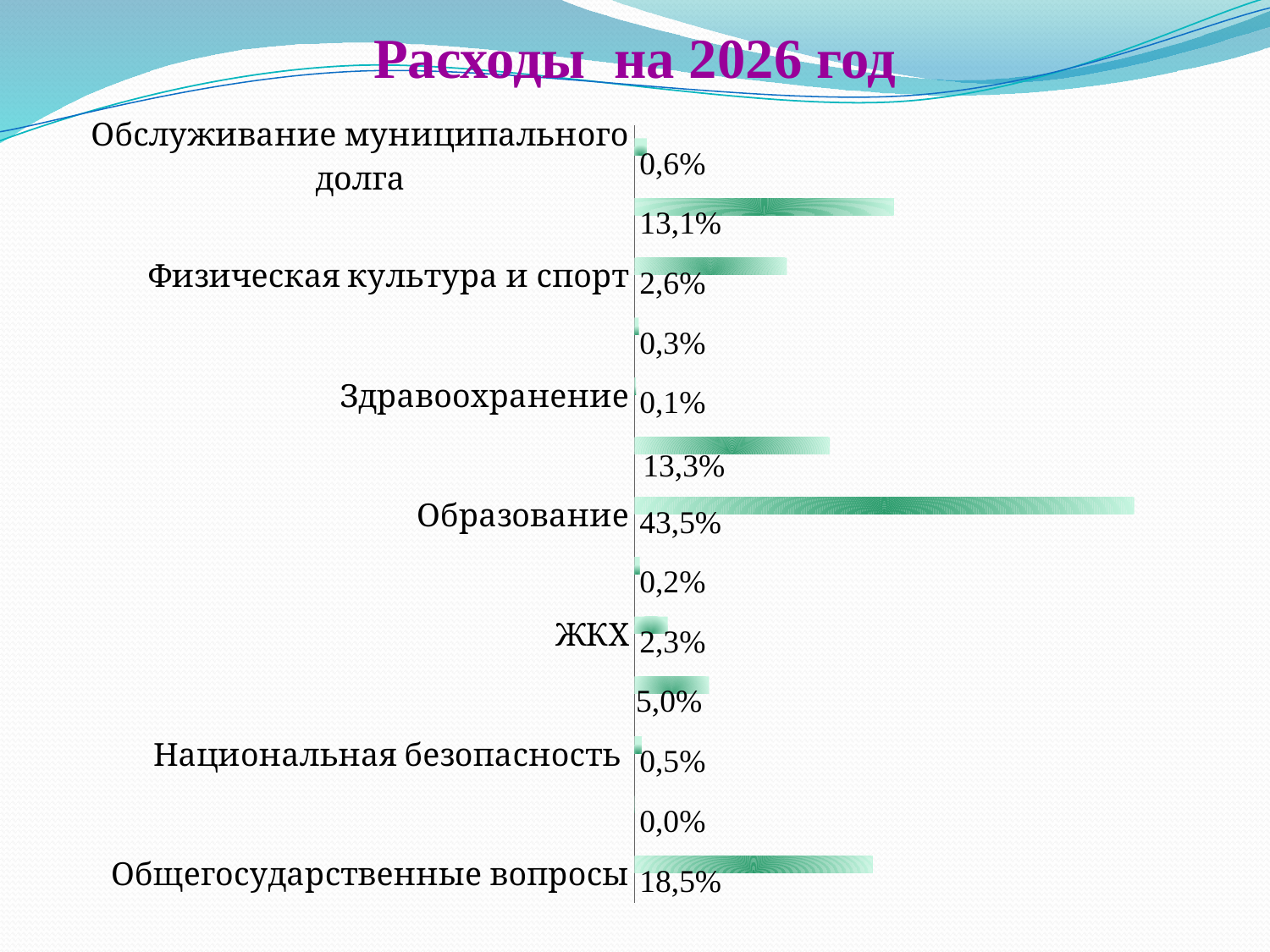
What is the value for ЖКХ? 2,3% Which is larger, the value for Физическая культура и спорт or the value for ЖКХ? Физическая культура и спорт Which category has the highest value? Образование What is the title of the slide? Расходы на 2026 год What is the value for Общегосударственные вопросы? 18,5% What is the value for Образование? 43,5% What kind of chart is shown on the slide? Bar chart What is the value for Обслуживание муниципального долга? 0,6% What is the difference between the values for Образование and Общегосударственные вопросы? 25,0% What is the value for Физическая культура и спорт? 2,6% What is the value for Национальная безопасность? 0,5% What is the value for Здравоохранение? 0,1%